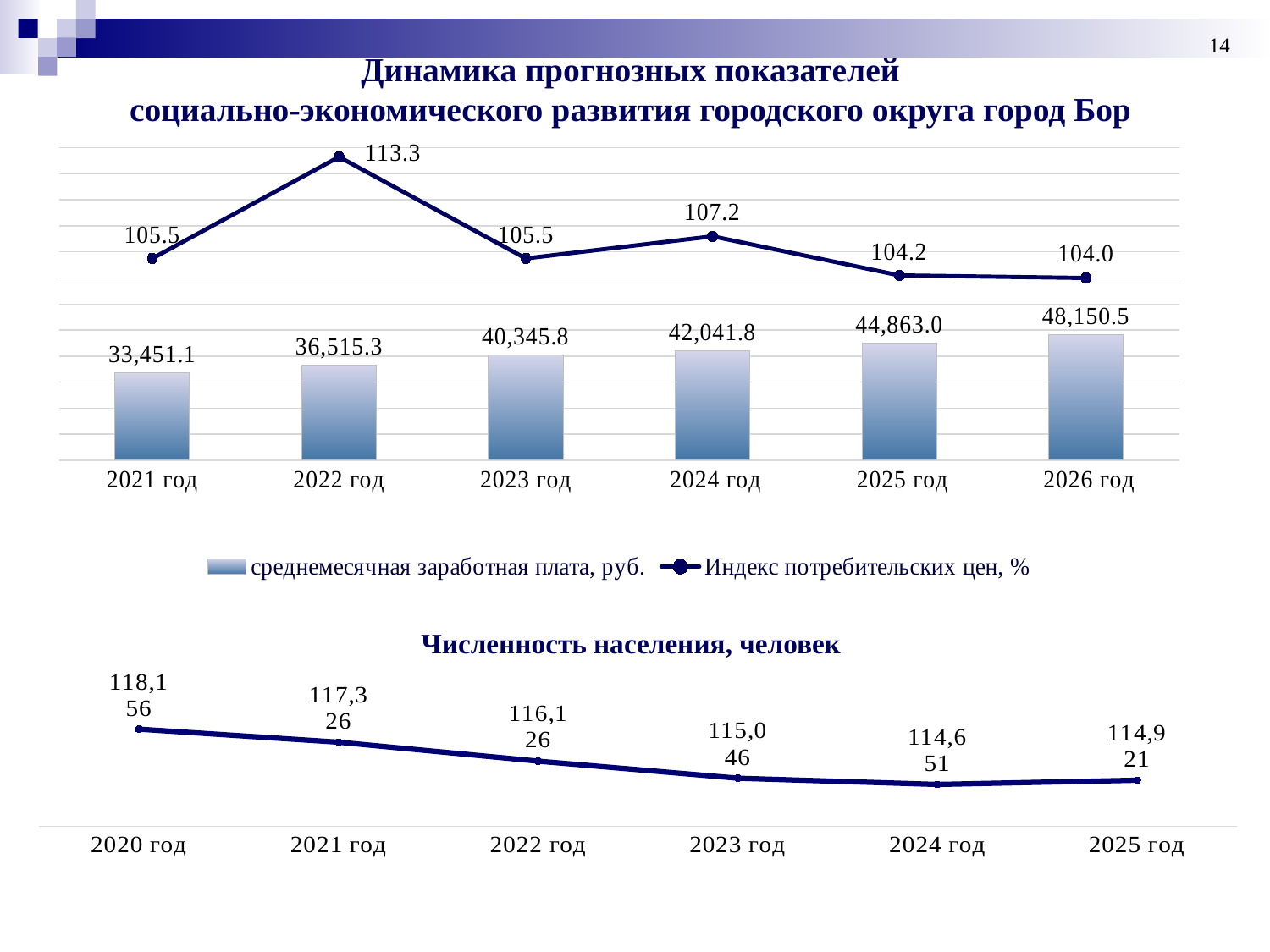
In the top chart, do the average monthly wage bars rise or fall from 2021 год to 2026 год? rise In the top chart, which year has the lowest consumer price index? 2026 год In the top chart, what is the average monthly wage for 2026 год? 48,150.5 In the bottom chart, how many years are plotted on the x axis? 6 In the top chart, what is the value of the consumer price index (Индекс потребительских цен) for 2022 год? 113.3 In the top chart, what is the difference between the average monthly wage in 2026 год and in 2025 год? 3,287.5 What is the title of the bottom chart? Численность населения, человек In the top chart, how many series does the legend list? 2 In the bottom chart, which year has the highest population? 2020 год In the top chart, is the consumer price index higher in 2024 год or in 2025 год? 2024 год In the top chart, which year has the highest consumer price index? 2022 год In the top chart, what is the average monthly wage (среднемесячная заработная плата) for 2021 год? 33,451.1